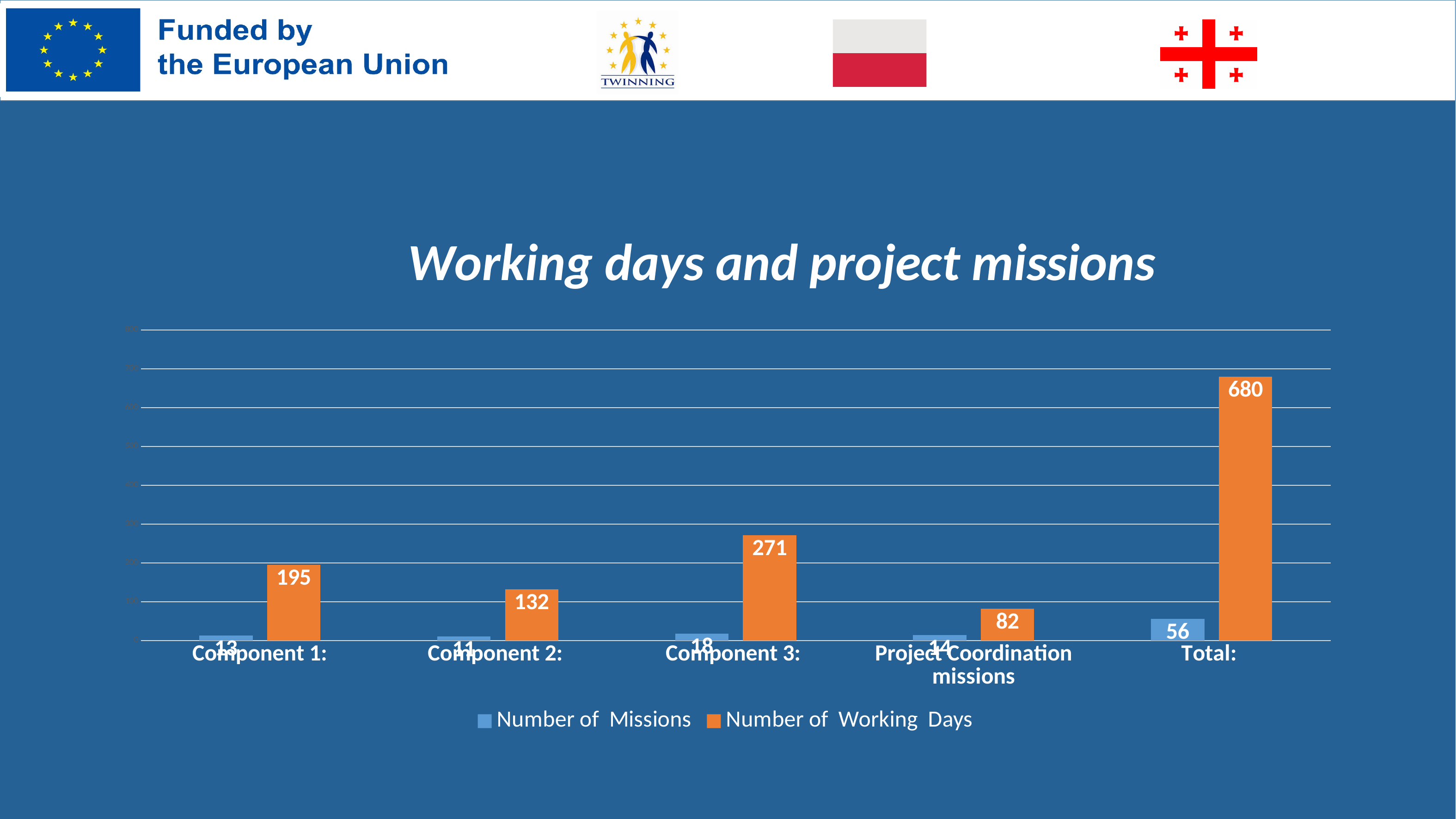
What is the difference in Number of Working Days between Component 1 and Component 2? 63 What kind of chart is shown on the slide? Bar chart How many series does the legend list? 2 What is the title of the chart? Working days and project missions How many categories are shown on the x axis? 5 What is the Number of Working Days for Project Coordination missions? 82 Which category has the lowest Number of Working Days? Project Coordination missions Which has more Number of Missions, Component 3 or Project Coordination missions? Component 3 What is the Number of Missions for Component 2? 11 What is the Number of Missions shown for Total? 56 Excluding the Total category, which category has the highest Number of Working Days? Component 3 What is the Number of Working Days for Component 3? 271